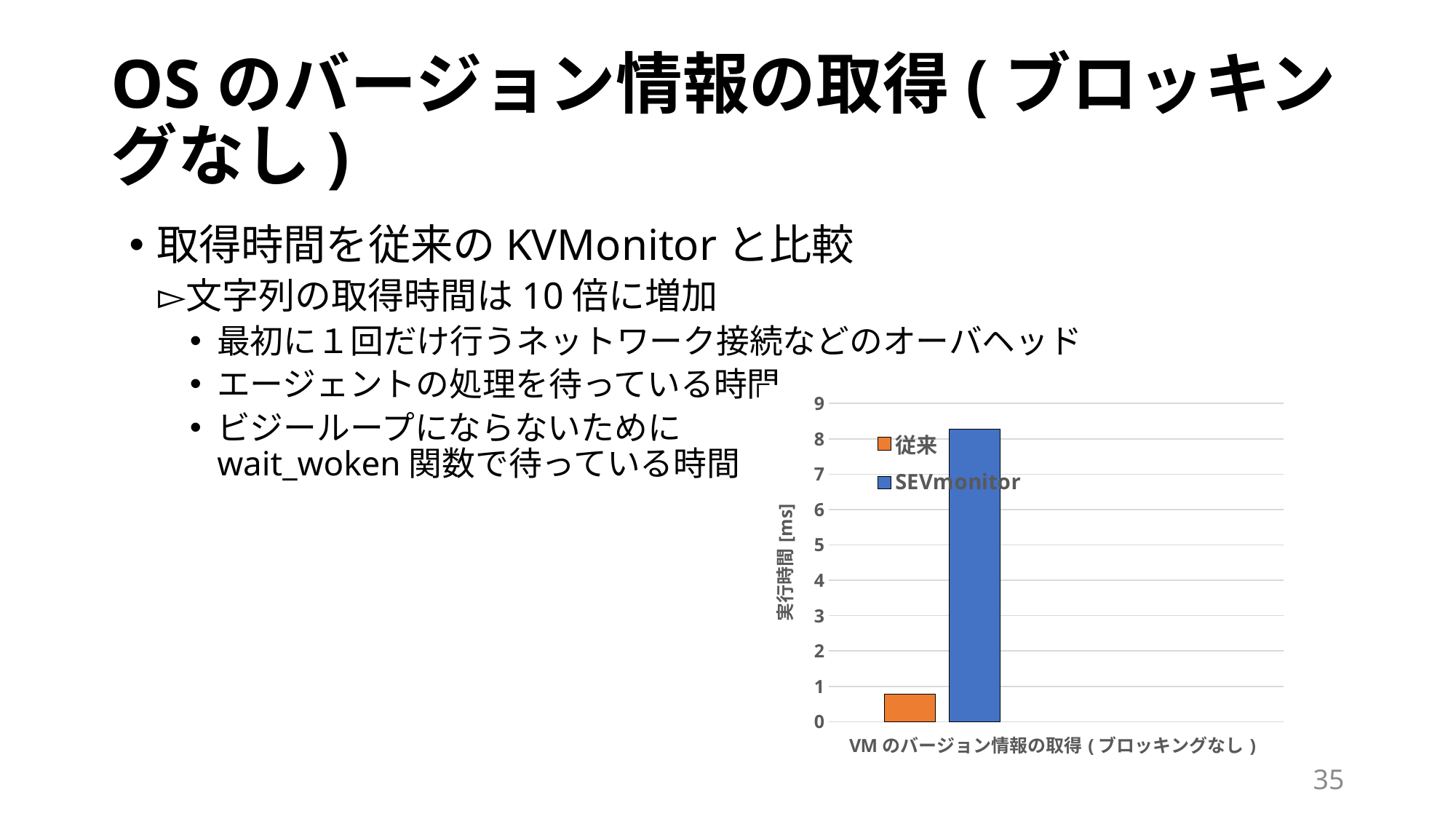
Is the value for 従来 greater or less than 1? less Is the value for SEVmonitor greater or less than 8? greater Which colour represents the SEVmonitor series in the chart? blue What is the label of the vertical axis of the chart? 実行時間 [ms] Which series has the higher value in the chart, 従来 or SEVmonitor? SEVmonitor How many categories are shown on the x axis of the chart? 1 Which series has the highest value in the chart? SEVmonitor Is the value for SEVmonitor greater or less than 5? greater Which series has the lowest value in the chart? 従来 How many series does the chart legend list? 2 What kind of chart is shown on the slide? bar chart